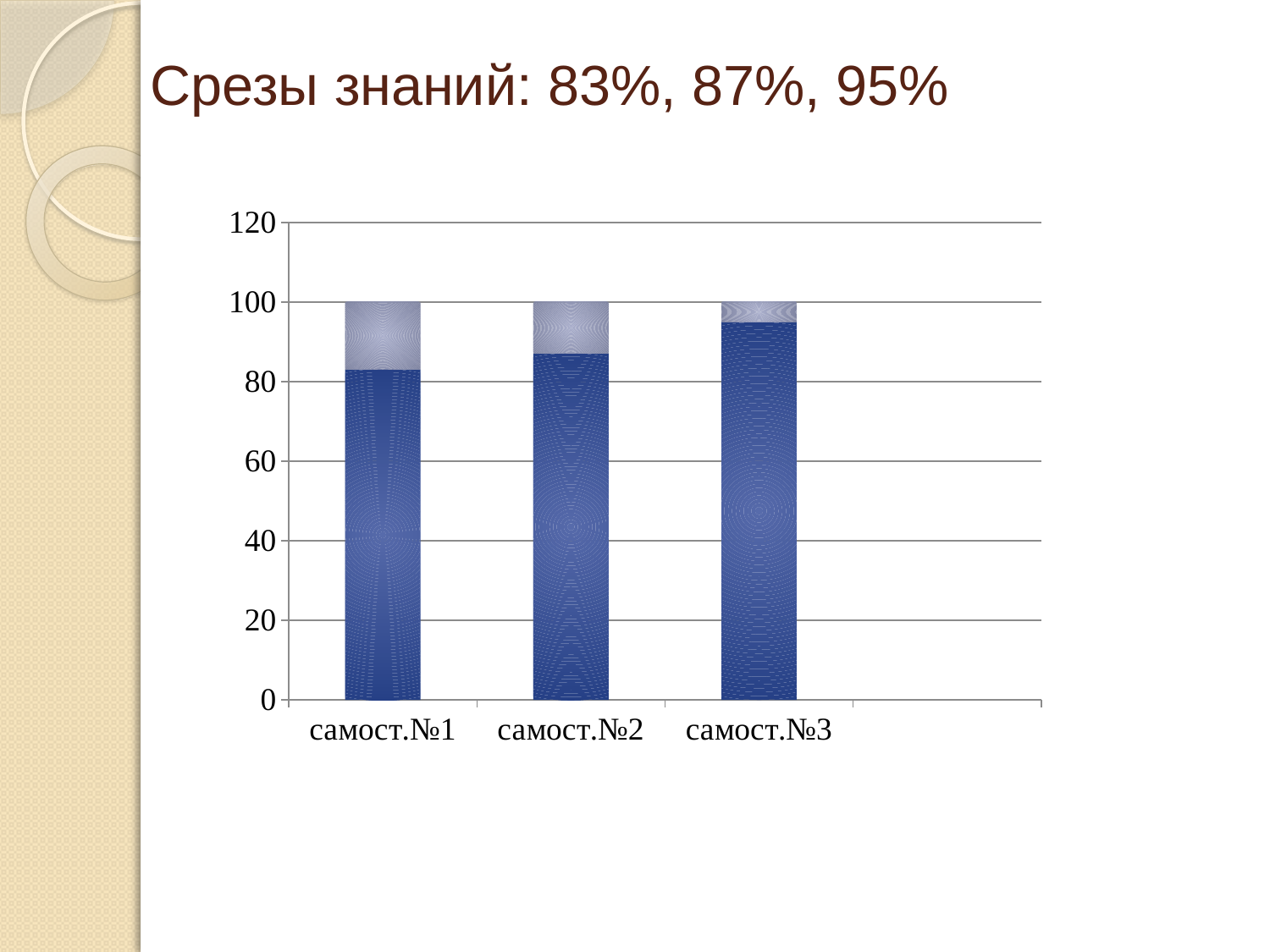
According to the slide title, what is the value of the third knowledge check (самост.№3)? 95% What is the total height of the stacked bar for самост.№3? 100 Which category has the tallest dark blue segment? самост.№3 Is the dark blue value for самост.№3 greater or less than 100? less Which category has the shortest dark blue segment? самост.№1 What is the total height of the stacked bar for самост.№1? 100 Is the dark blue value for самост.№1 greater or less than 80? greater How many categories are shown on the x axis of the chart? 3 Do the dark blue segments rise or fall from самост.№1 to самост.№3? rise What kind of chart is shown on the slide? bar chart What is the title of the slide above the chart? Срезы знаний: 83%, 87%, 95% Is the dark blue segment for самост.№3 larger or smaller than the dark blue segment for самост.№1? larger